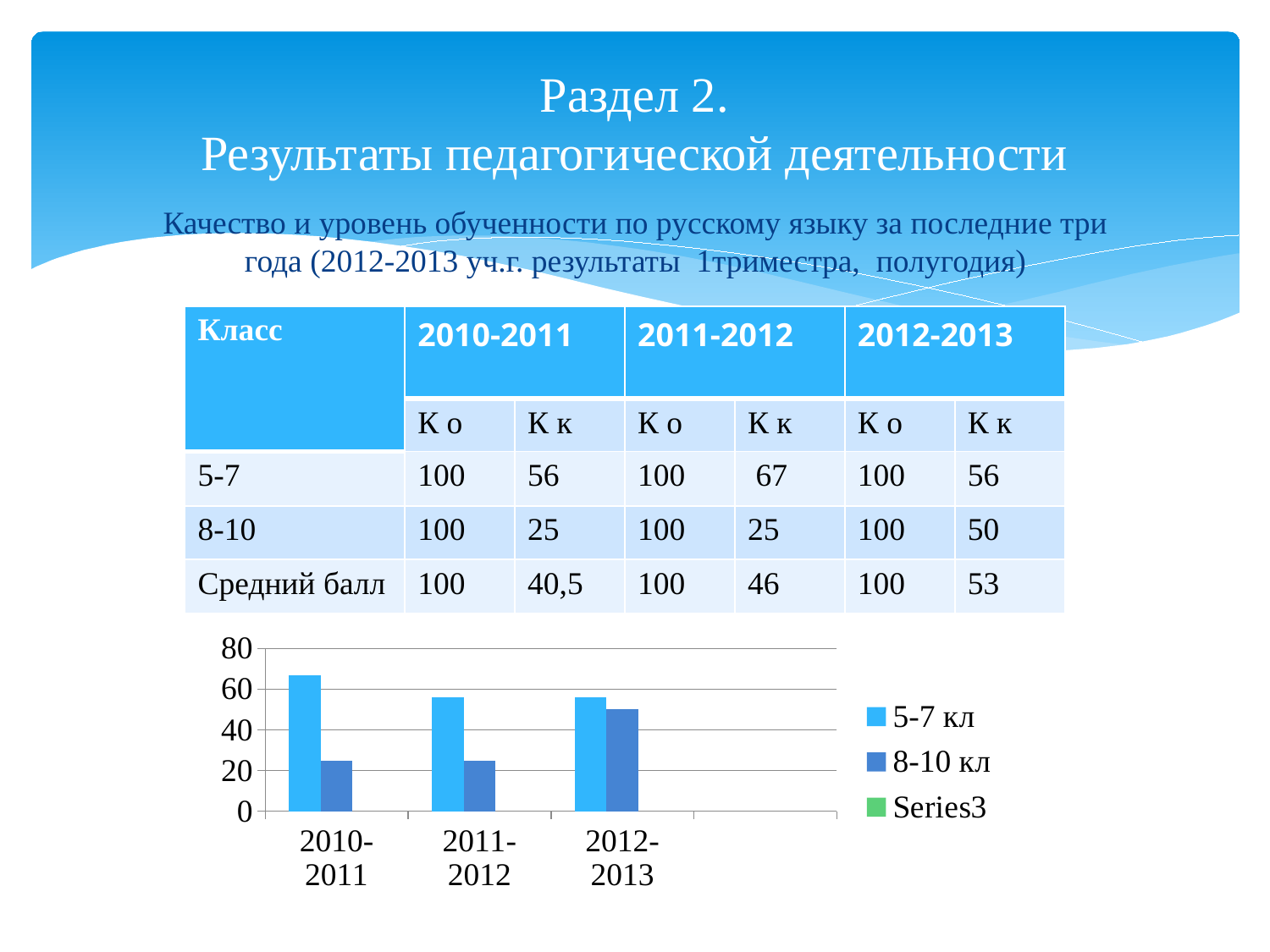
In which year is the bar for 5-7 кл the highest? 2010-2011 How many series does the chart legend list? 3 What kind of chart is shown on the slide? bar chart Is the value for 5-7 кл in 2011-2012 greater or less than 40? greater How many year categories are shown on the x axis of the chart? 3 Does the value for 5-7 кл rise or fall from 2010-2011 to 2011-2012? fall Is the value for 5-7 кл in 2010-2011 greater or less than 60? greater Is the value for 8-10 кл in 2010-2011 greater or less than 40? less What is the highest value shown on the chart's vertical axis? 80 In 2010-2011, which series has the larger bar, 5-7 кл or 8-10 кл? 5-7 кл In which year is the bar for 8-10 кл the highest? 2012-2013